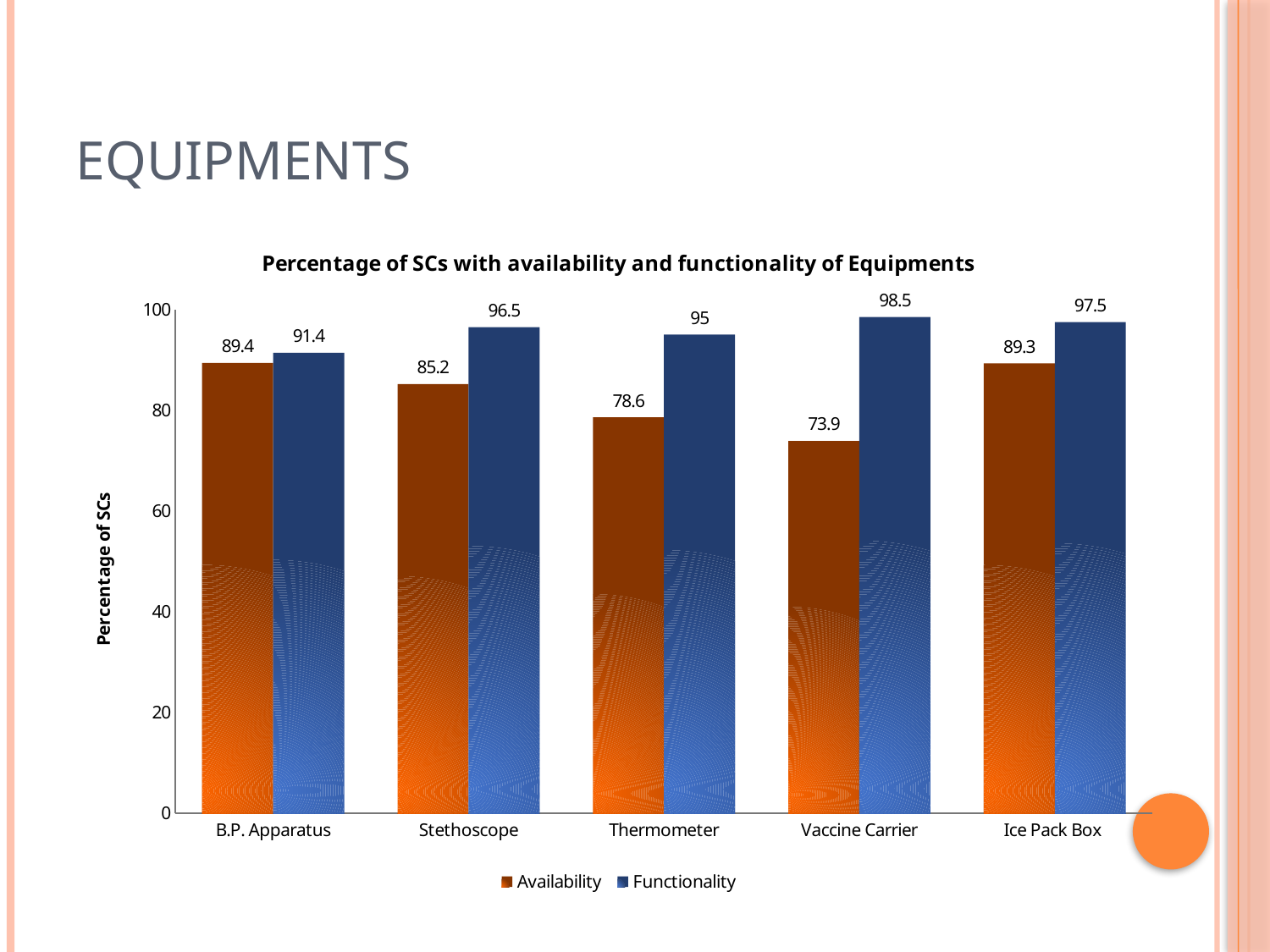
What is the difference between the Functionality and Availability values for Vaccine Carrier? 24.6 What is the Availability value for Ice Pack Box? 89.3 What is the title of the chart? Percentage of SCs with availability and functionality of Equipments What is the label of the y axis? Percentage of SCs How many categories are shown on the x axis? 5 What is the Availability value for Thermometer? 78.6 Which category has the lowest Availability value? Vaccine Carrier How many series does the legend list? 2 Which is larger, the Availability value for B.P. Apparatus or the Availability value for Stethoscope? B.P. Apparatus Which category has the highest Functionality value? Vaccine Carrier What kind of chart is shown on the slide? Bar chart What is the Functionality value for Vaccine Carrier? 98.5